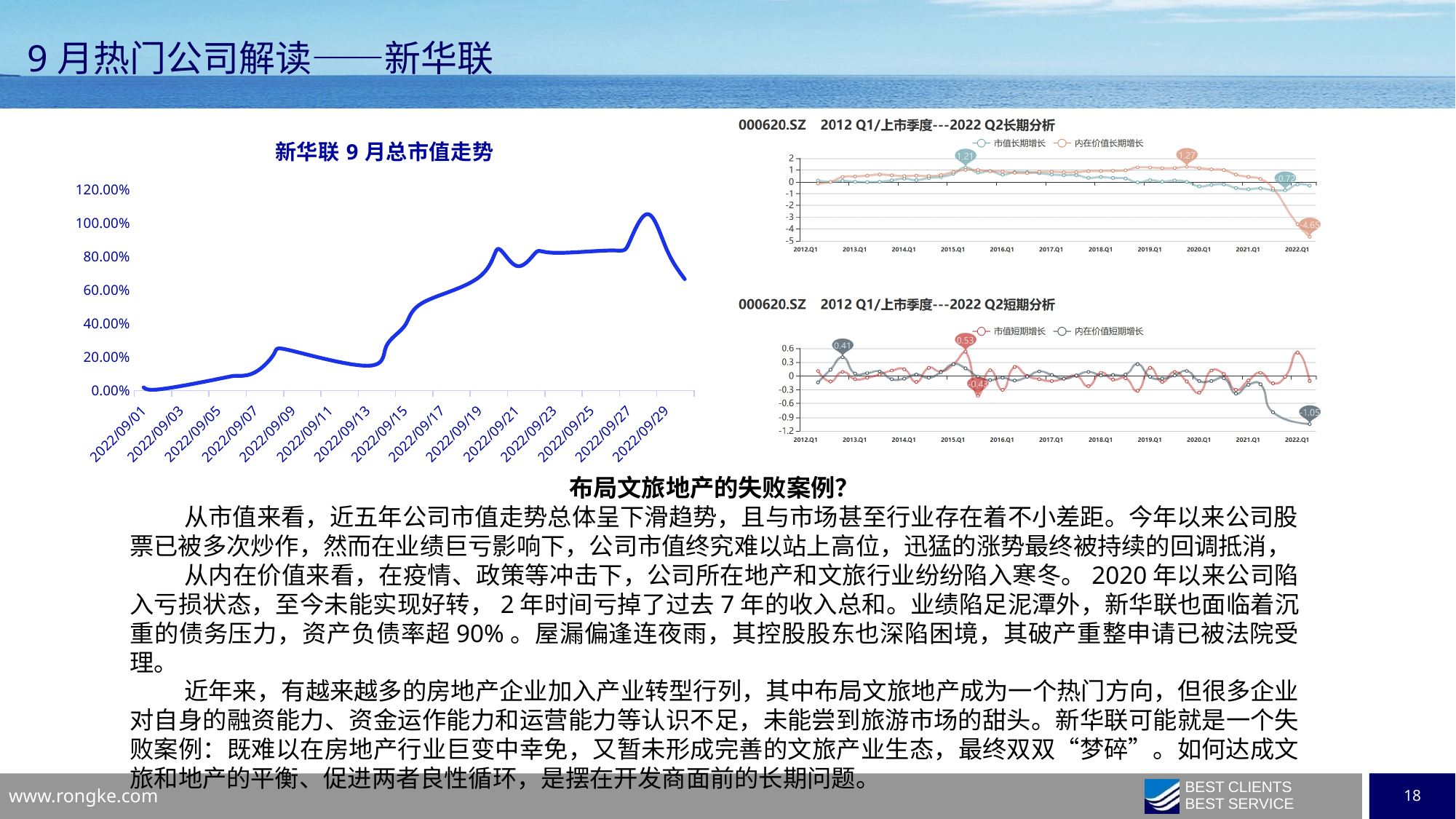
In the top-right chart 000620.SZ 长期分析, what is the labeled value of 内在价值长期增长 at the end of the series near 2022.Q1? -4.65 In the top-right chart 000620.SZ 长期分析, which is larger: the labeled value 1.21 of 市值长期增长 or the labeled value 0.72 of 市值长期增长? 1.21 In the left chart 新华联 9 月总市值走势, does the value overall rise or fall from 2022/09/01 to 2022/09/29? rise In the left chart 新华联 9 月总市值走势, is the value at 2022/09/29 greater or less than 60.00%? greater In the bottom-right chart 000620.SZ 短期分析, what is the labeled value of 内在价值短期增长 near 2022.Q1? -1.05 In the top-right chart 000620.SZ 长期分析, what is the labeled peak value of 内在价值长期增长 near 2019-2020? 1.27 How many date labels are shown on the x axis of the left chart 新华联 9 月总市值走势? 15 What kind of chart is the left chart titled 新华联 9 月总市值走势? line chart In the left chart 新华联 9 月总市值走势, is the peak value reached around 2022/09/28 greater or less than 100.00%? greater How many series does the legend list in the top-right chart 000620.SZ 2012 Q1/上市季度---2022 Q2长期分析? 2 In the left chart 新华联 9 月总市值走势, is the value at 2022/09/01 greater or less than 20.00%? less In the bottom-right chart 000620.SZ 短期分析, what is the highest labeled value of 市值短期增长? 0.53